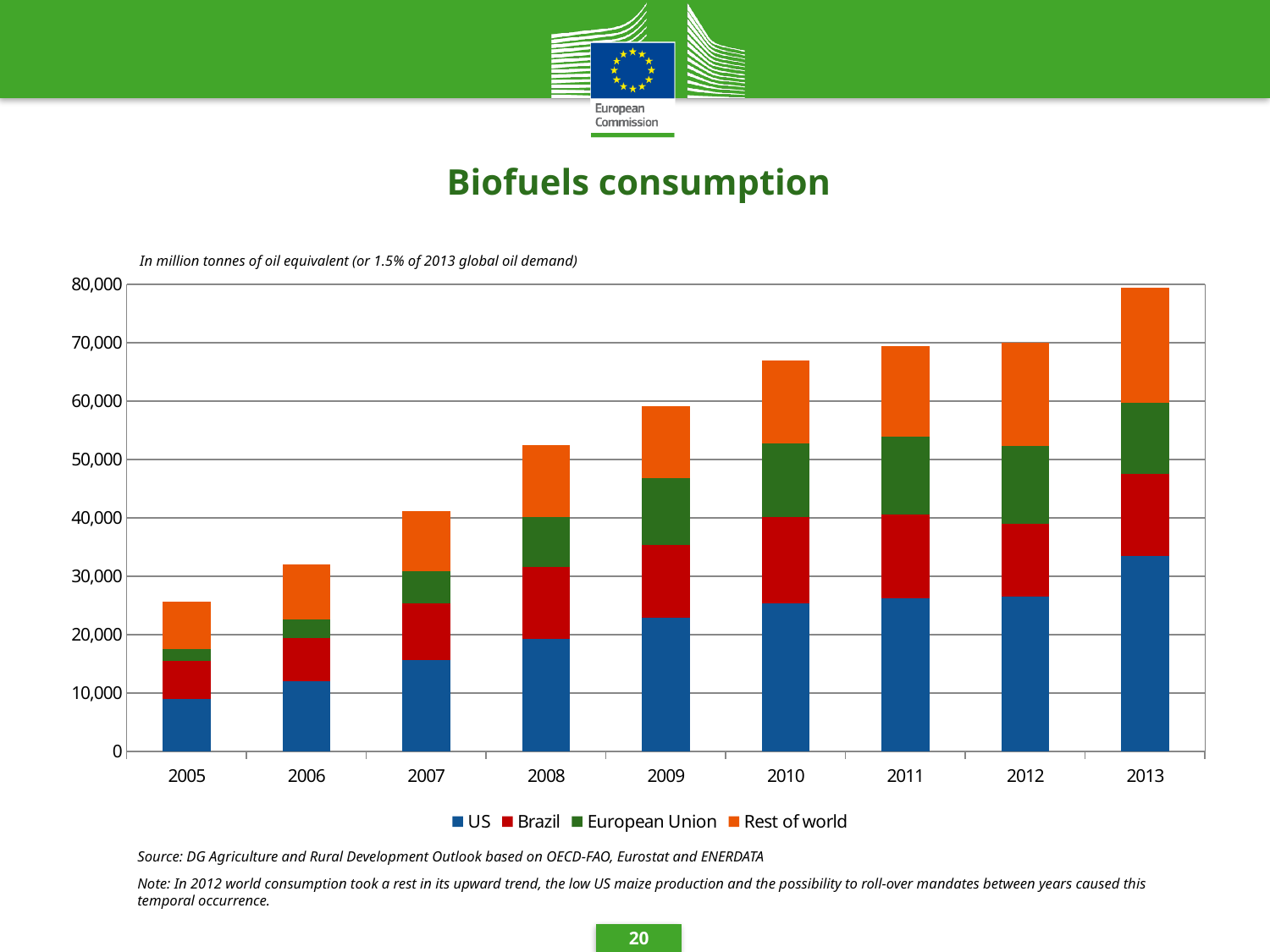
Do total biofuels consumption values generally rise or fall from 2005 to 2013? rise What kind of chart is shown on the slide? Stacked bar chart Which year has the highest total biofuels consumption? 2013 Is the US segment for 2013 greater or less than 30,000? greater Which year has the lowest total biofuels consumption? 2005 How many series does the legend list? 4 Which year has a larger total bar, 2008 or 2010? 2010 Which series is shown in orange in the legend? Rest of world Is the total bar for 2013 greater or less than 70,000? greater Is the total bar for 2010 greater or less than 60,000? greater How many years are shown on the x axis of the chart? 9